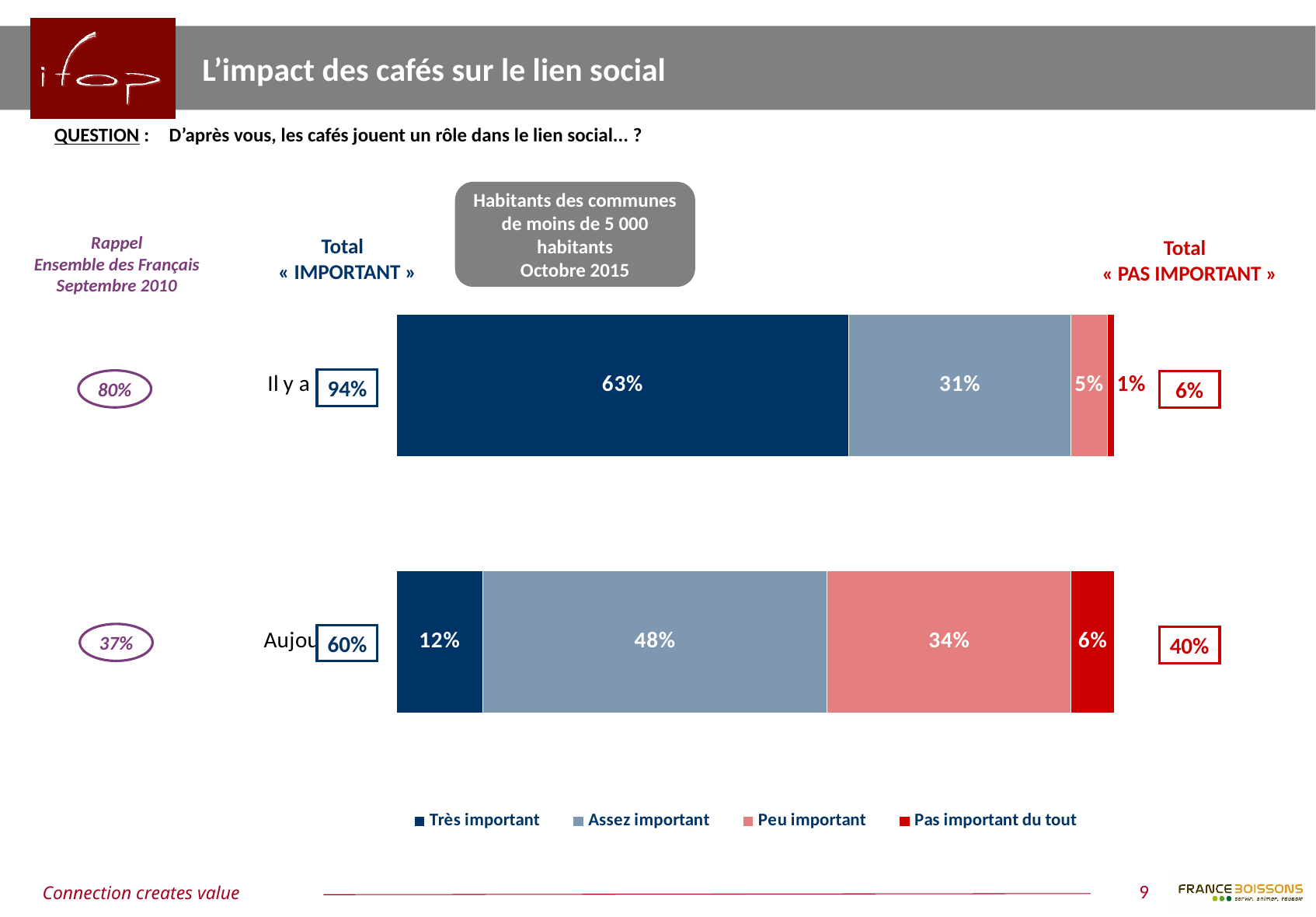
Which is larger: "Peu important" in the top bar or "Peu important" in the bottom bar? bottom bar In the bottom bar, what is the value for "Peu important"? 34% Which segment is the largest in the bottom bar? Assez important What is the difference between the "Très important" values of the top bar and the bottom bar? 51 percentage points In the bottom bar, what is the value for "Pas important du tout"? 6% What colour is used for the "Pas important du tout" series in the legend? red In the top bar, what is the value for "Assez important"? 31% What kind of chart is shown on the slide? stacked bar chart How many bars are plotted in the chart? 2 In the top bar, what is the value for "Très important"? 63% How many series does the chart legend list? 4 Which segment is the smallest in the top bar? Pas important du tout